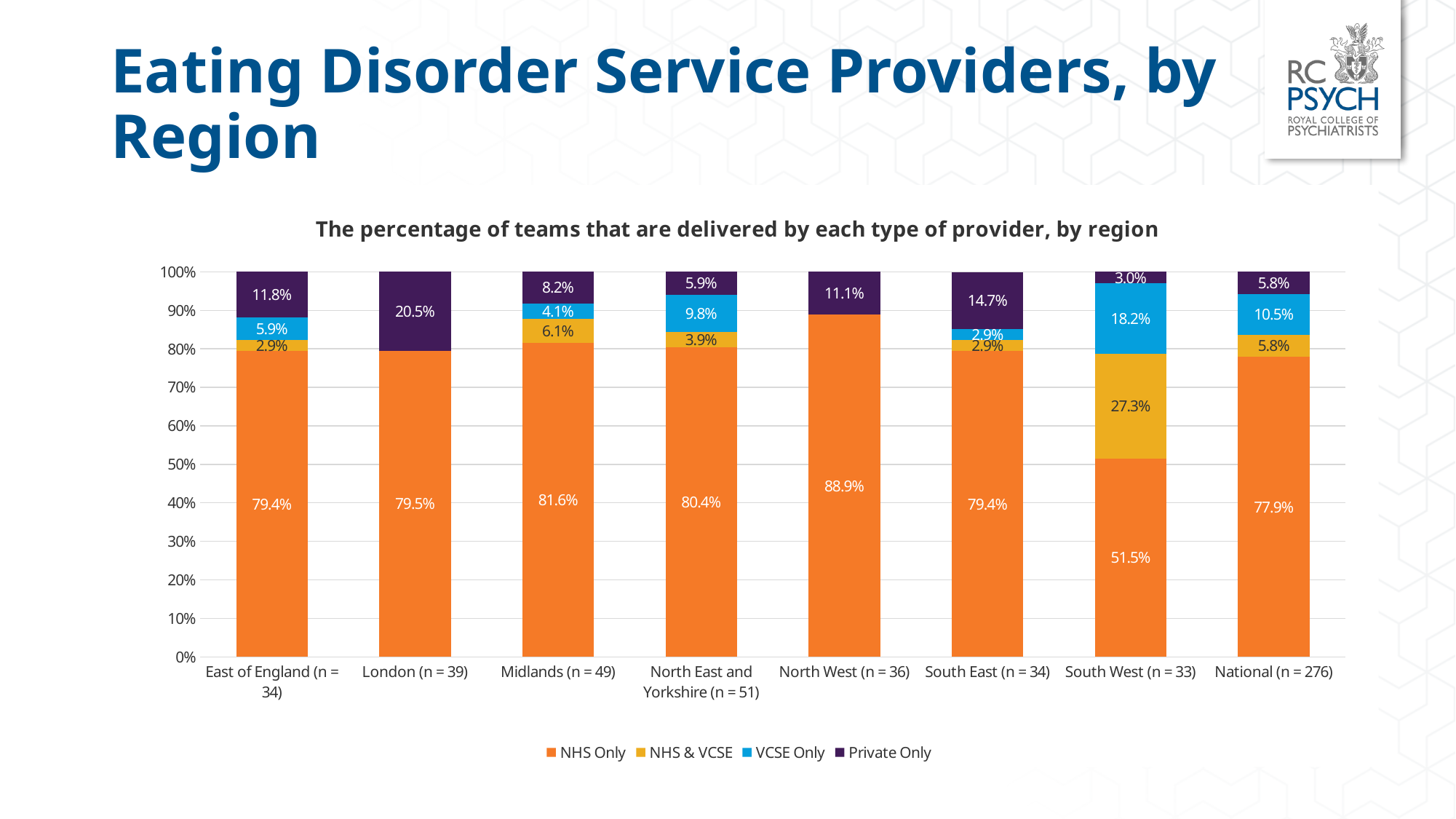
How many series does the legend list? 4 Which region has the highest Private Only percentage? London (n = 39) What is the NHS & VCSE percentage for South West (n = 33)? 27.3% How many regions (categories) are shown on the x axis? 8 What is the NHS Only percentage for North West (n = 36)? 88.9% What kind of chart is shown on the slide? Stacked bar chart What is the VCSE Only percentage for National (n = 276)? 10.5% What is the Private Only percentage for London (n = 39)? 20.5% What is the difference between the NHS Only percentage for North West (n = 36) and South West (n = 33)? 37.4% Which is larger, the VCSE Only percentage for South West (n = 33) or for North East and Yorkshire (n = 51)? South West (n = 33) Which region has the lowest NHS Only percentage? South West (n = 33) Which region has the highest NHS Only percentage? North West (n = 36)